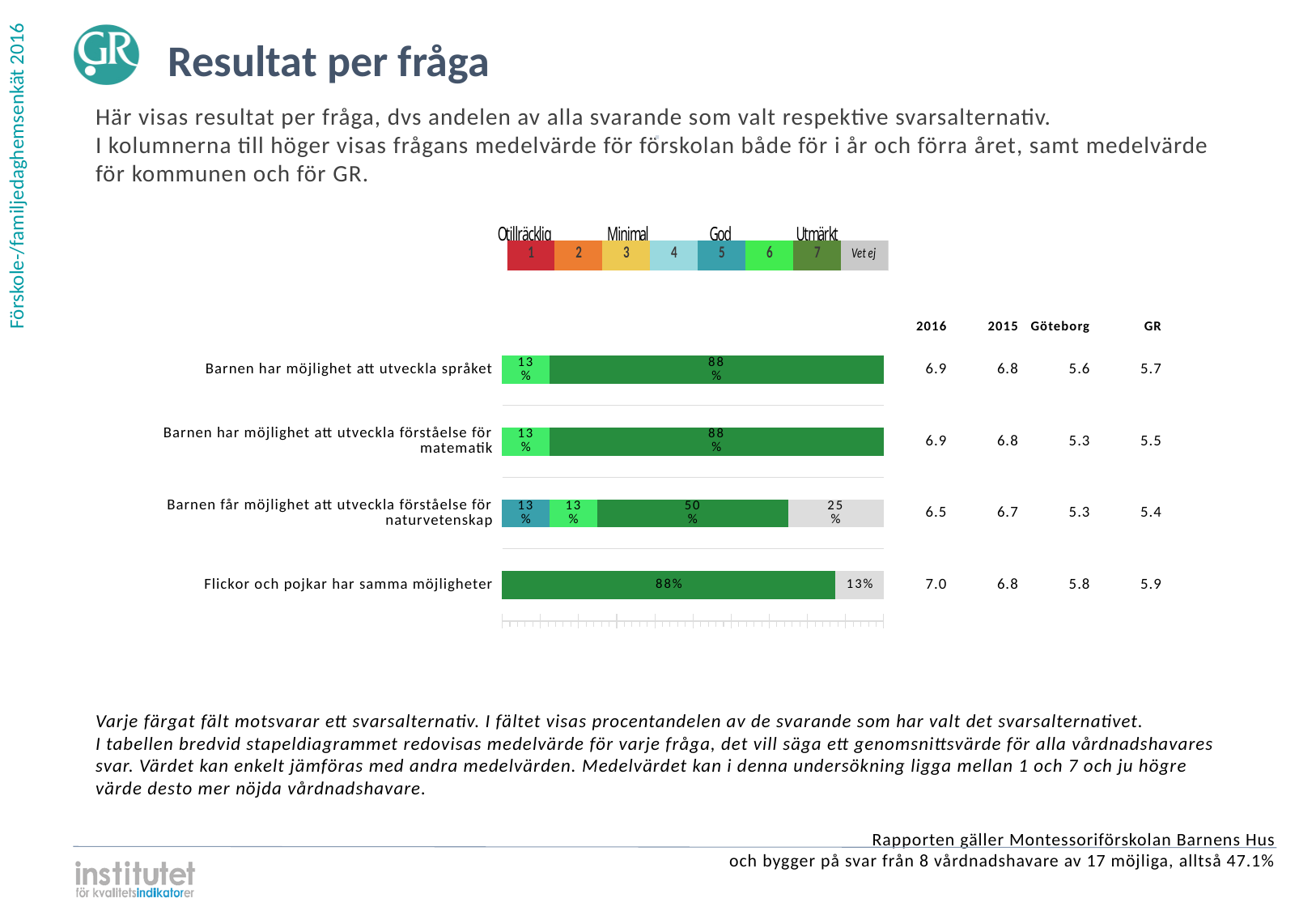
What kind of chart is shown on the slide? stacked bar chart What is the Göteborg mean value for 'Barnen har möjlighet att utveckla språket'? 5.6 What percentage of respondents chose answer 6 (light green) for 'Barnen har möjlighet att utveckla förståelse för matematik'? 13% What percentage of respondents chose answer 7 (dark green) for 'Barnen har möjlighet att utveckla språket'? 88% What percentage of respondents chose answer 7 (dark green) for 'Barnen får möjlighet att utveckla förståelse för naturvetenskap'? 50% What percentage of respondents answered 'Vet ej' for 'Flickor och pojkar har samma möjligheter'? 13% Which question has the lowest 2016 mean value? Barnen får möjlighet att utveckla förståelse för naturvetenskap What is the 2016 mean value for 'Flickor och pojkar har samma möjligheter'? 7.0 How many answer alternatives does the colour legend above the chart list, including 'Vet ej'? 8 How many questions (categories) are plotted in the bar chart? 4 What percentage of respondents answered 'Vet ej' for 'Barnen får möjlighet att utveckla förståelse för naturvetenskap'? 25% What is the difference between the 2016 and 2015 mean values for 'Barnen har möjlighet att utveckla språket'? 0.1